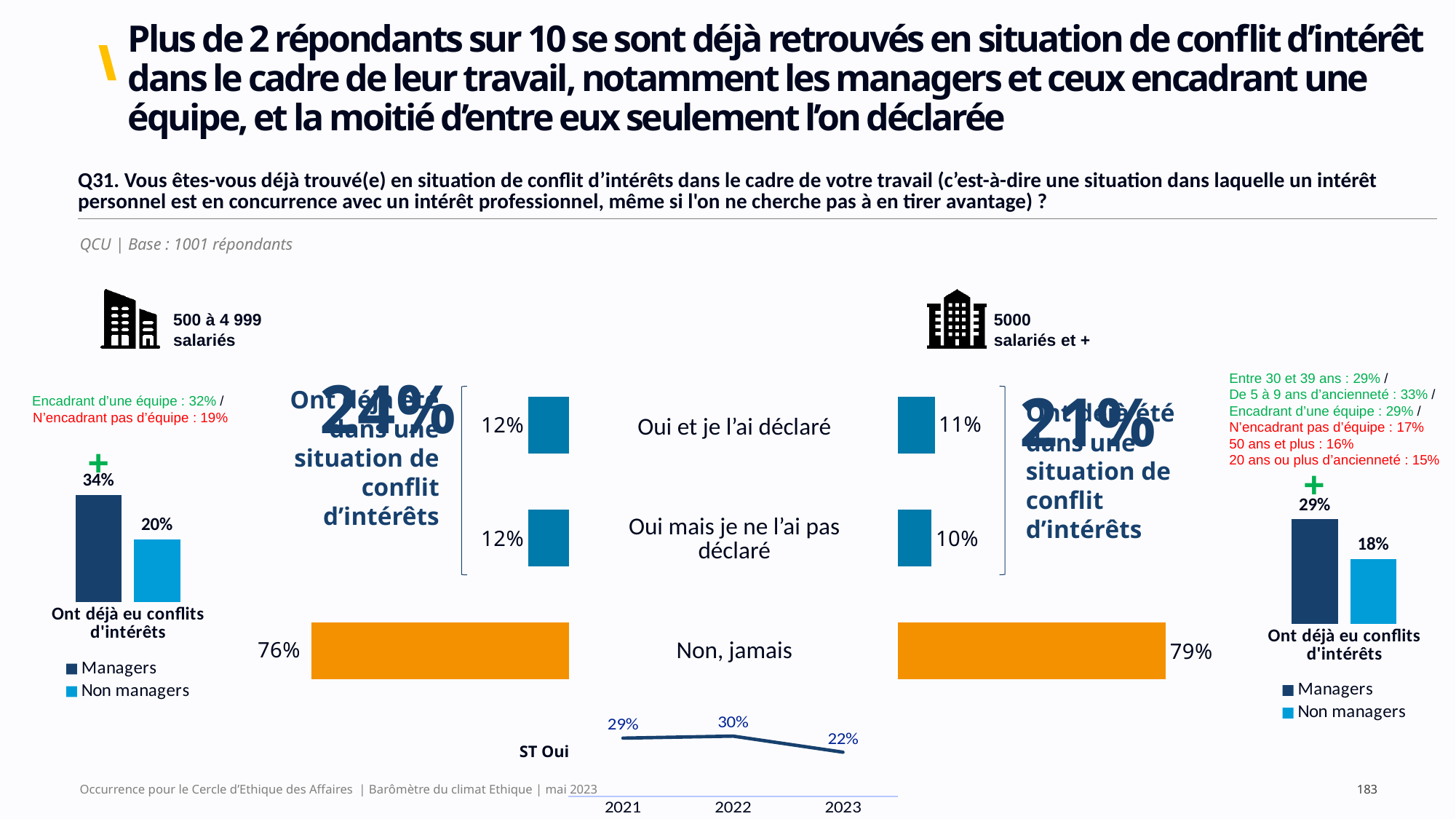
In the right-hand bar chart "Ont déjà eu conflits d'intérêts" (5000 salariés et +), what is the value for Non managers? 18% In the horizontal bar chart for companies with 5000 salariés et +, which category has the lowest value? Oui mais je ne l'ai pas déclaré In the horizontal bar chart for companies with 500 à 4 999 salariés, what is the value for "Non, jamais"? 76% In the right-hand bar chart "Ont déjà eu conflits d'intérêts" (5000 salariés et +), which is larger, Managers or Non managers? Managers In the horizontal bar chart for companies with 500 à 4 999 salariés, which category has the highest value? Non, jamais In the "ST Oui" line chart at the bottom, how many years are plotted? 3 In the horizontal bar chart for companies with 5000 salariés et +, what is the value for "Oui et je l'ai déclaré"? 11% In the "ST Oui" line chart at the bottom, what is the difference between the 2022 and 2023 values? 8 points In the left-hand bar chart "Ont déjà eu conflits d'intérêts" (500 à 4 999 salariés), what is the difference between Managers and Non managers? 14 points In the horizontal bar chart for companies with 5000 salariés et +, what is the value for "Oui mais je ne l'ai pas déclaré"? 10% In the "ST Oui" line chart at the bottom, what is the value for 2022? 30% In the left-hand bar chart "Ont déjà eu conflits d'intérêts" (500 à 4 999 salariés), what is the value for Managers? 34%